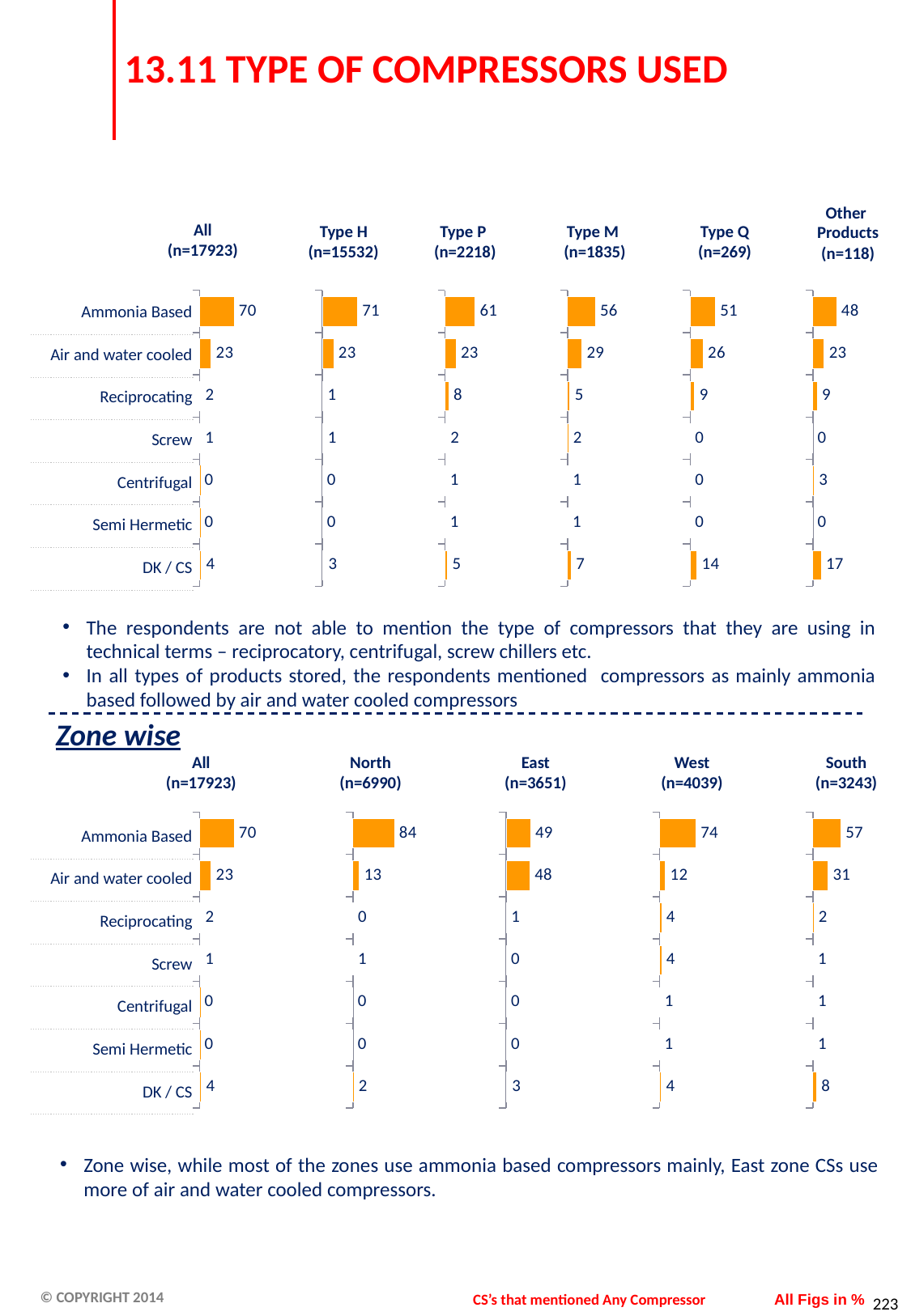
In the Zone wise set of charts, what is the value for Ammonia Based in the North (n=6990) chart? 84 In the top set of charts (by product type), what is the value for Ammonia Based in the Type H (n=15532) chart? 71 In the top set of charts, which product type chart has the highest value for Ammonia Based? Type H In the Zone wise set of charts, which zone chart has the lowest value for Ammonia Based? East In the top set of charts, is the Reciprocating value larger in the Type Q chart or the Type H chart? Type Q In the Zone wise set of charts, which zone chart has the highest value for DK / CS? South In the Zone wise set of charts, what is the value for Air and water cooled in the South (n=3243) chart? 31 In the top set of charts, what is the value for DK / CS in the Other Products (n=118) chart? 17 In the Zone wise set of charts, what is the difference between Ammonia Based and Air and water cooled in the East (n=3651) chart? 1 What kind of chart is used on this slide? Bar chart How many compressor categories are listed in each chart on the slide? 7 In the top set of charts, what is the difference between the Ammonia Based value and the Air and water cooled value in the Type M (n=1835) chart? 27